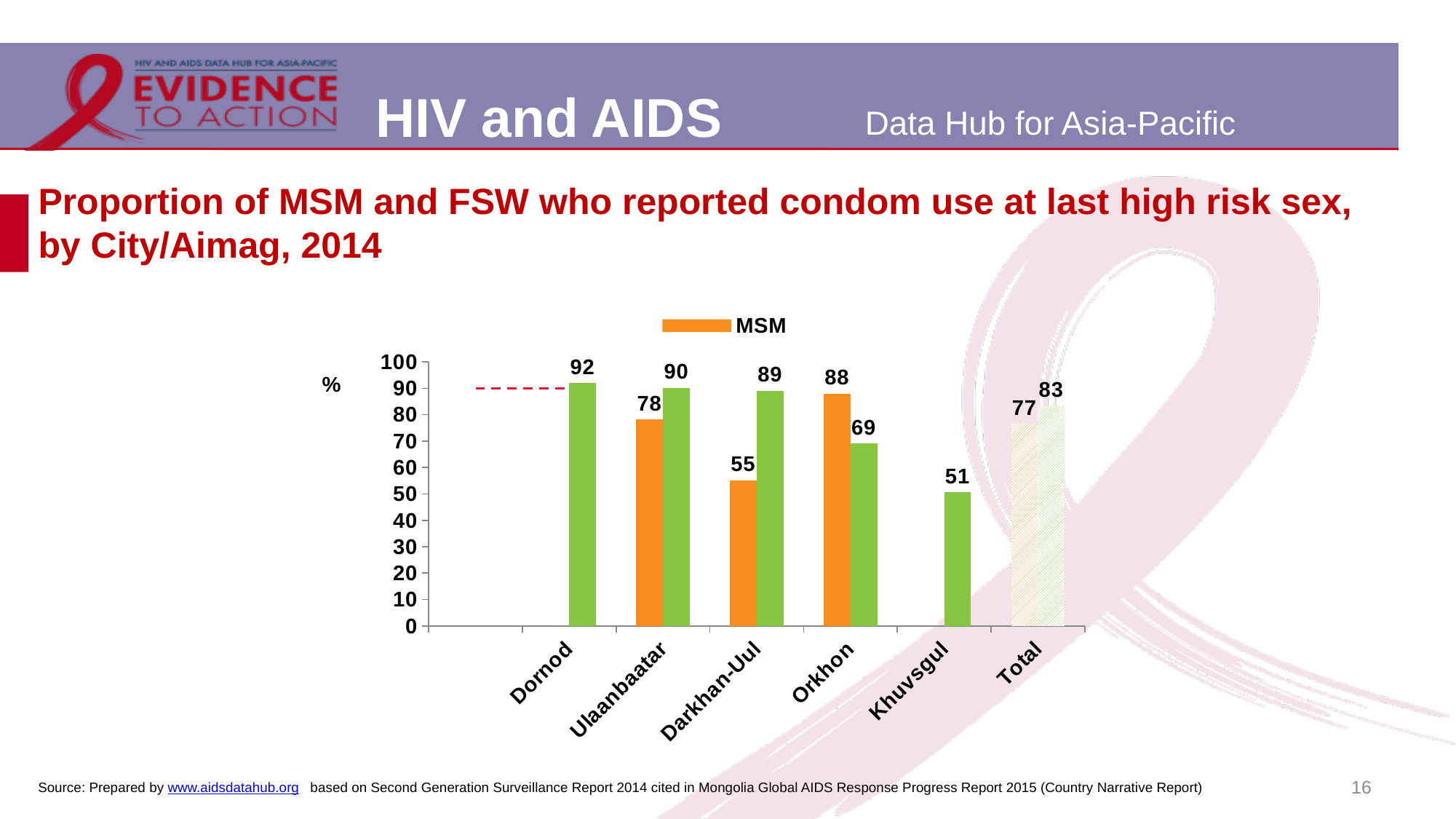
Which city/aimag has the highest MSM value? Orkhon What is the value of the green bar for Khuvsgul? 51 What is the value of the green bar for Dornod? 92 What is the MSM value for Ulaanbaatar? 78 For Darkhan-Uul, which is larger: the MSM bar or the green bar? the green bar Which city/aimag has the lowest green bar value? Khuvsgul What kind of chart is shown on the slide? bar chart What is the difference between the MSM value and the green bar value for Orkhon? 19 What is the MSM value for the Total category? 77 How many categories are shown on the x axis? 6 What is the MSM value for Darkhan-Uul? 55 Which series name is readable in the chart legend? MSM